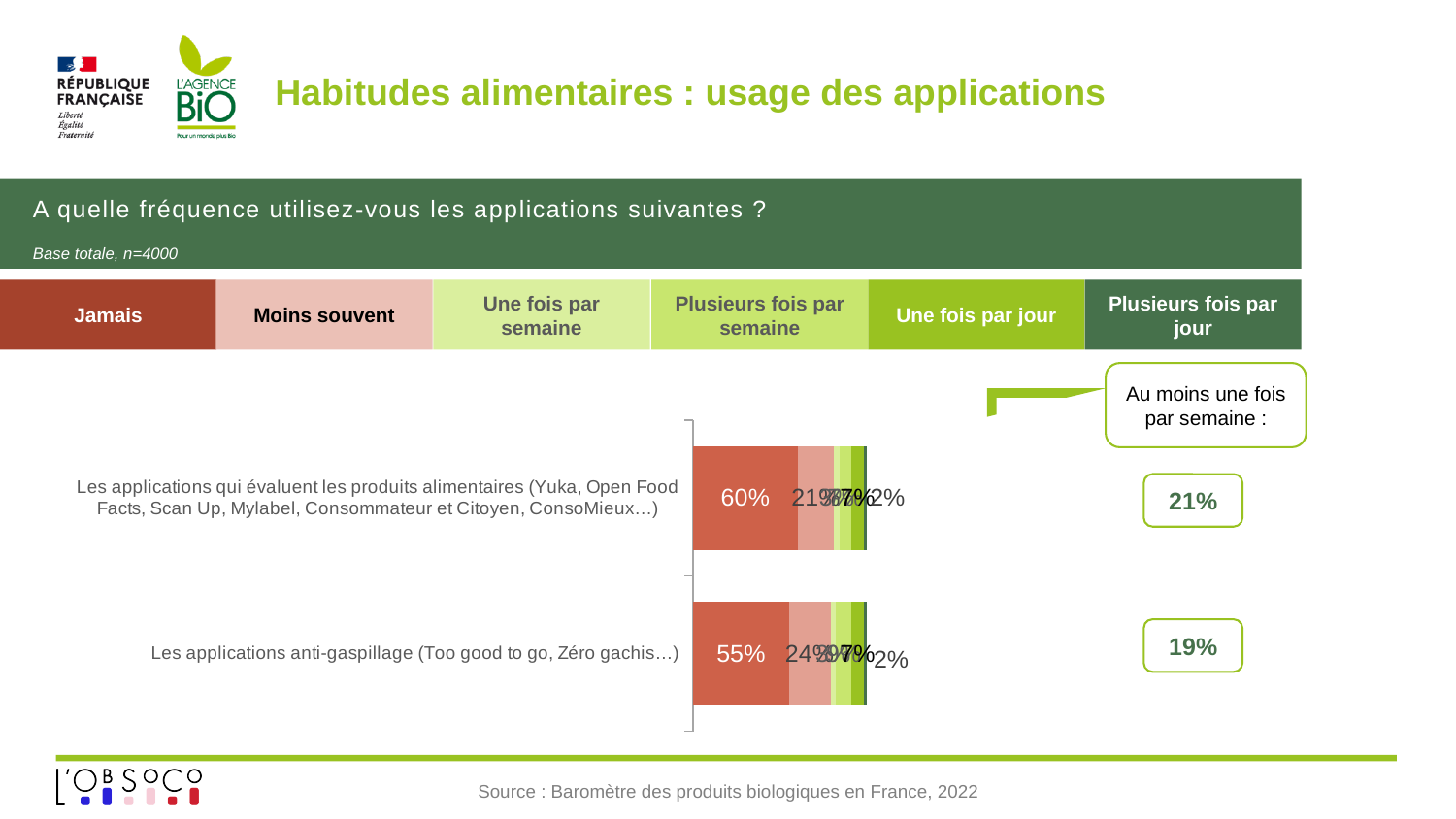
What is the 'Moins souvent' value for 'Les applications qui évaluent les produits alimentaires'? 21% What kind of chart is shown on the slide? stacked bar chart What is the 'Jamais' value for 'Les applications anti-gaspillage (Too good to go, Zéro gachis…)'? 55% What is the 'Jamais' value for 'Les applications qui évaluent les produits alimentaires (Yuka, Open Food Facts, Scan Up, Mylabel, Consommateur et Citoyen, ConsoMieux…)'? 60% Which legend entry is shown in the darkest red colour? Jamais How many series does the legend list? 6 What is the 'Au moins une fois par semaine' share for 'Les applications qui évaluent les produits alimentaires'? 21% Which category has the higher 'Jamais' value? Les applications qui évaluent les produits alimentaires What is the 'Moins souvent' value for 'Les applications anti-gaspillage'? 24% What is the 'Au moins une fois par semaine' share for 'Les applications anti-gaspillage'? 19% What is the difference between the 'Jamais' values of the two categories? 5% How many categories (rows) are plotted in the chart? 2